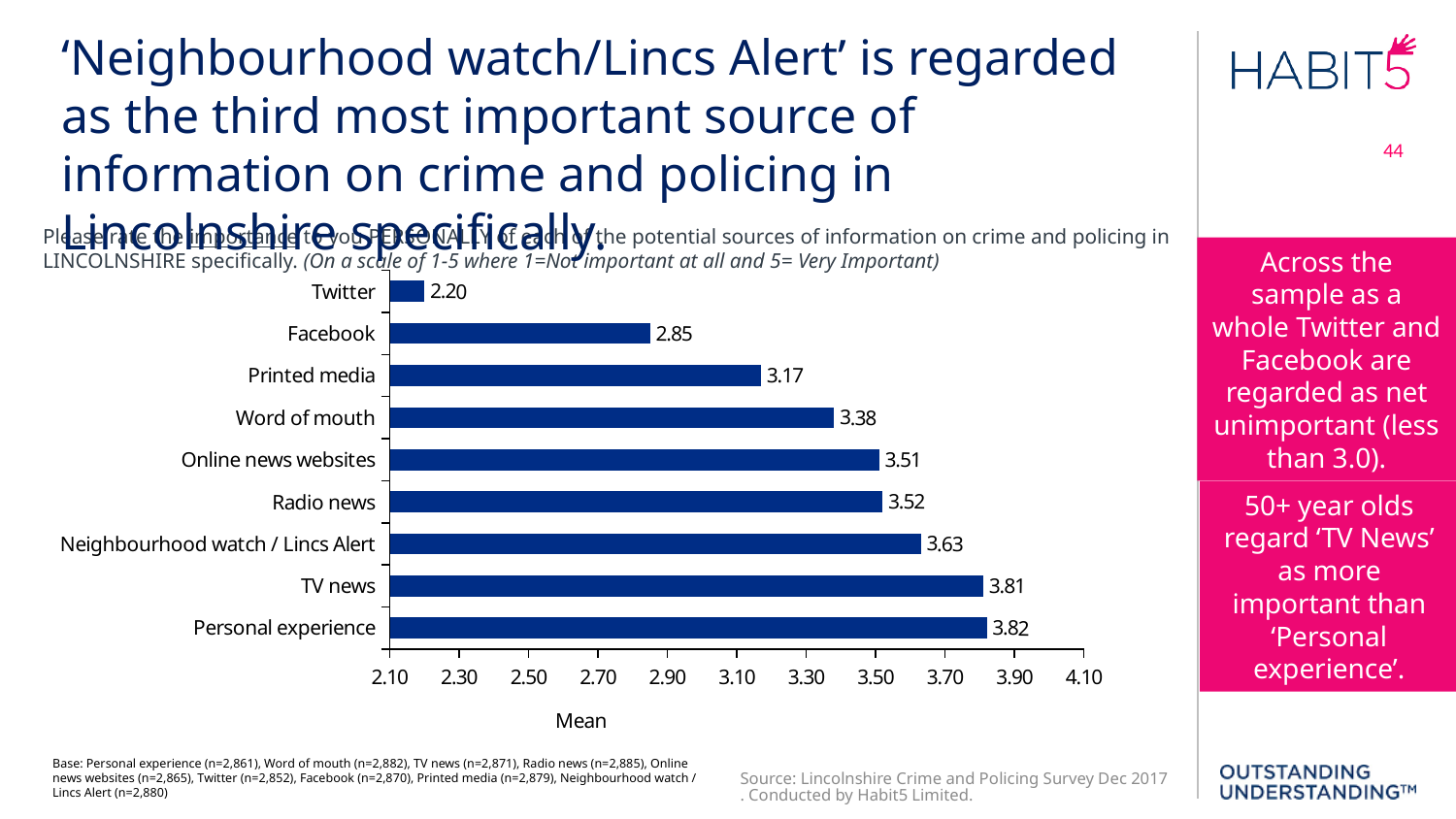
What type of chart is used on this slide? Bar chart Which source of information has the highest mean importance score? Personal experience What is the mean importance score for Neighbourhood watch / Lincs Alert? 3.63 What is the mean importance score for Online news websites? 3.51 Is the mean score for Facebook greater or less than 3.10? less Which has a higher mean importance score, Radio news or Printed media? Radio news How many sources of information are shown in the chart? 9 What is the difference between the mean scores for TV news and Facebook? 0.96 What is the label on the horizontal axis of the chart? Mean Which source of information has the lowest mean importance score? Twitter What is the mean importance score for Twitter? 2.20 What is the difference between the mean scores for Word of mouth and Printed media? 0.21